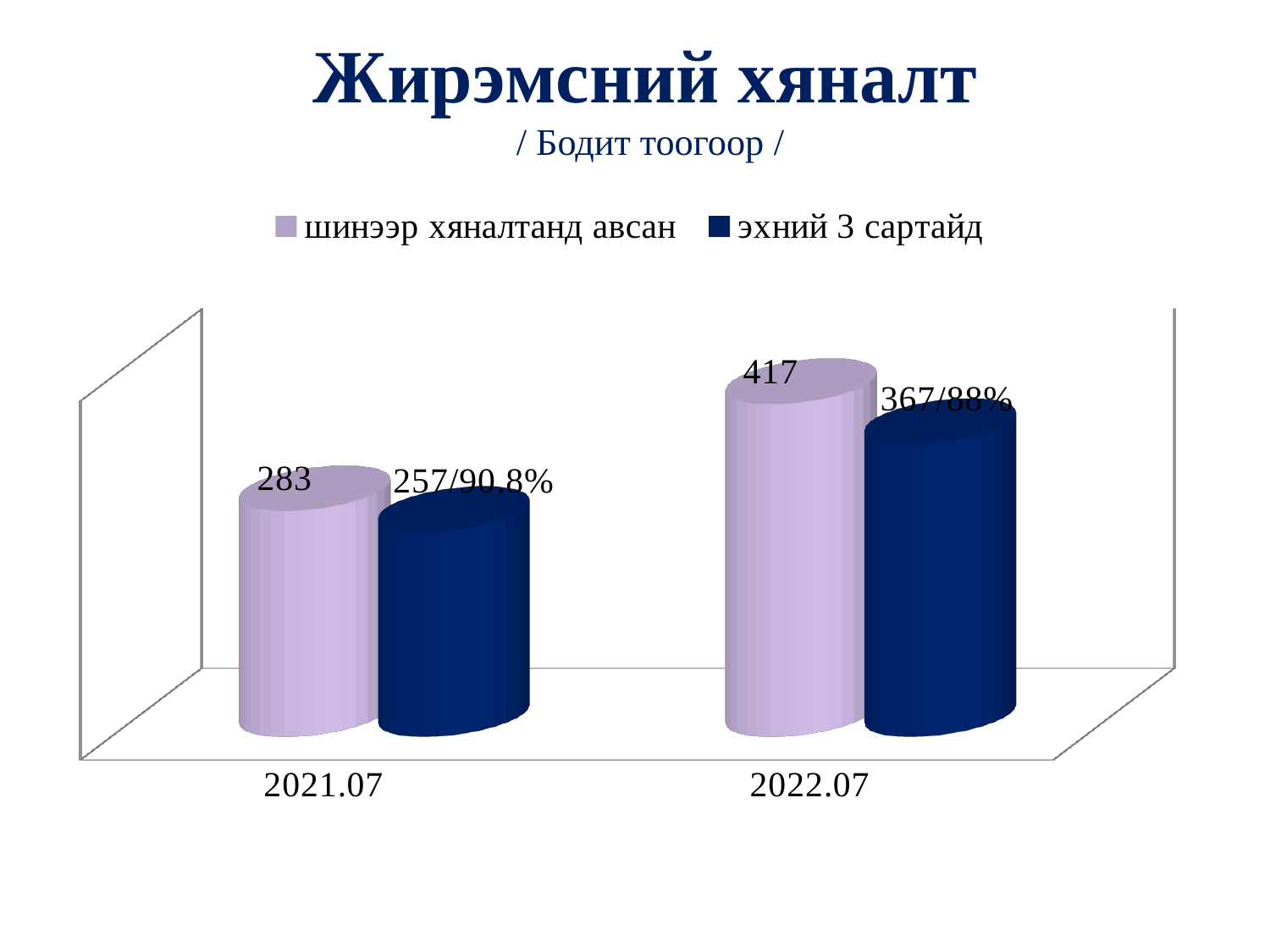
What is the data label for "эхний 3 сартайд" in 2022.07? 367/88% What is the difference between the "шинээр хяналтанд авсан" values for 2022.07 and 2021.07? 134 How many series does the legend list? 2 Which category has the lowest value for "эхний 3 сартайд"? 2021.07 How many categories are shown on the x axis? 2 Which category has the highest value for "шинээр хяналтанд авсан"? 2022.07 Do the values for "эхний 3 сартайд" rise or fall from 2021.07 to 2022.07? Rise What is the value for "шинээр хяналтанд авсан" in 2021.07? 283 What kind of chart is shown on the slide? Bar chart What is the value for "шинээр хяналтанд авсан" in 2022.07? 417 What is the data label for "эхний 3 сартайд" in 2021.07? 257/90.8% In 2022.07, which series has the larger value: "шинээр хяналтанд авсан" or "эхний 3 сартайд"? шинээр хяналтанд авсан